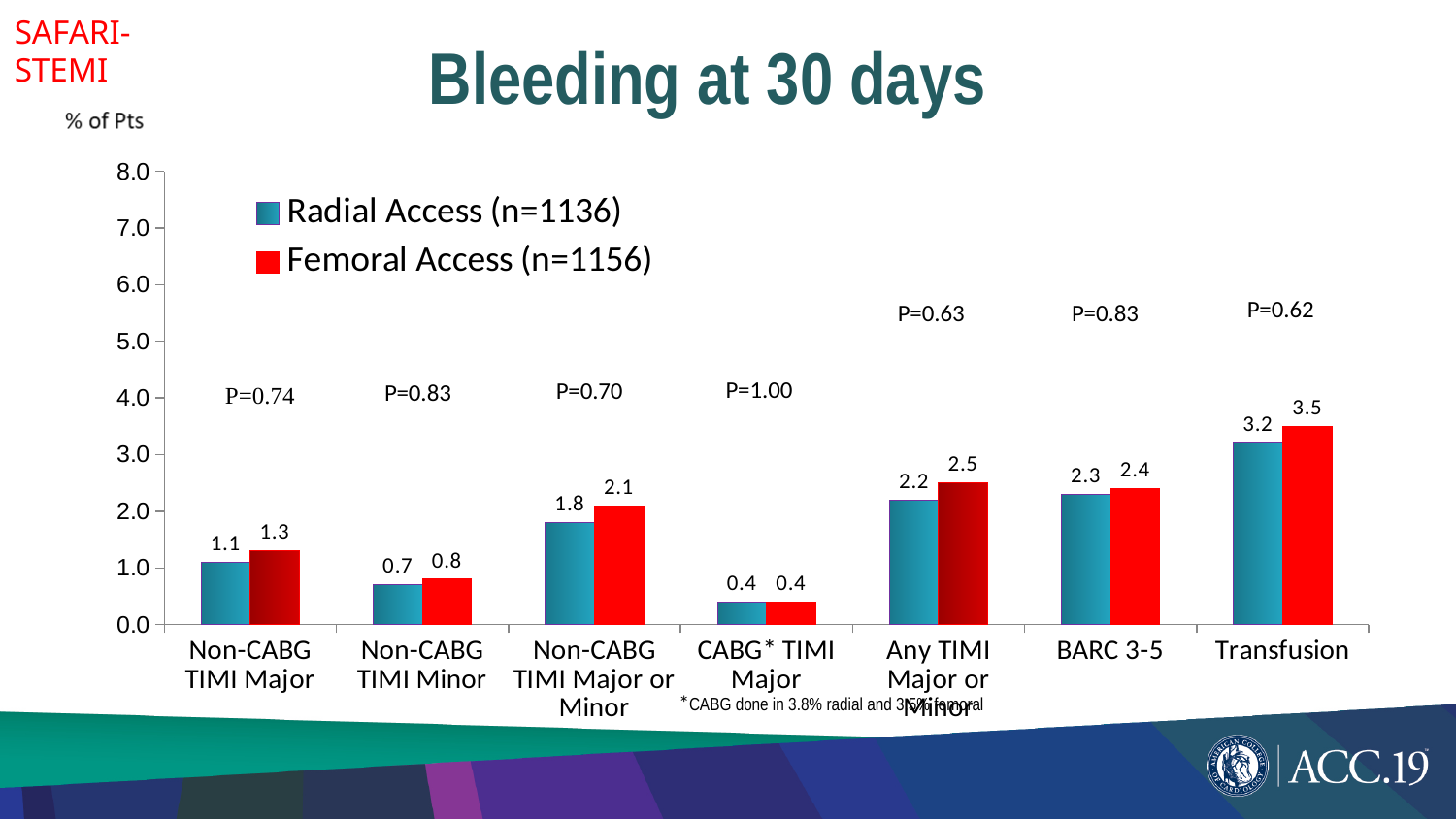
What is the title of the chart? Bleeding at 30 days What is the value for Femoral Access in the Transfusion category? 3.5 What is the value for Radial Access in the Non-CABG TIMI Major category? 1.1 Which category has the lowest value for Femoral Access? CABG* TIMI Major What kind of chart is shown on the slide? Bar chart How many series does the legend list? 2 What is the P value shown for the Transfusion category? P=0.62 How many categories are shown on the x axis? 7 What is the value for Femoral Access in the Any TIMI Major or Minor category? 2.5 Which is larger in the BARC 3-5 category, Radial Access or Femoral Access? Femoral Access Which category has the highest value for Radial Access? Transfusion What is the difference between the Femoral Access and Radial Access values for Non-CABG TIMI Major or Minor? 0.3